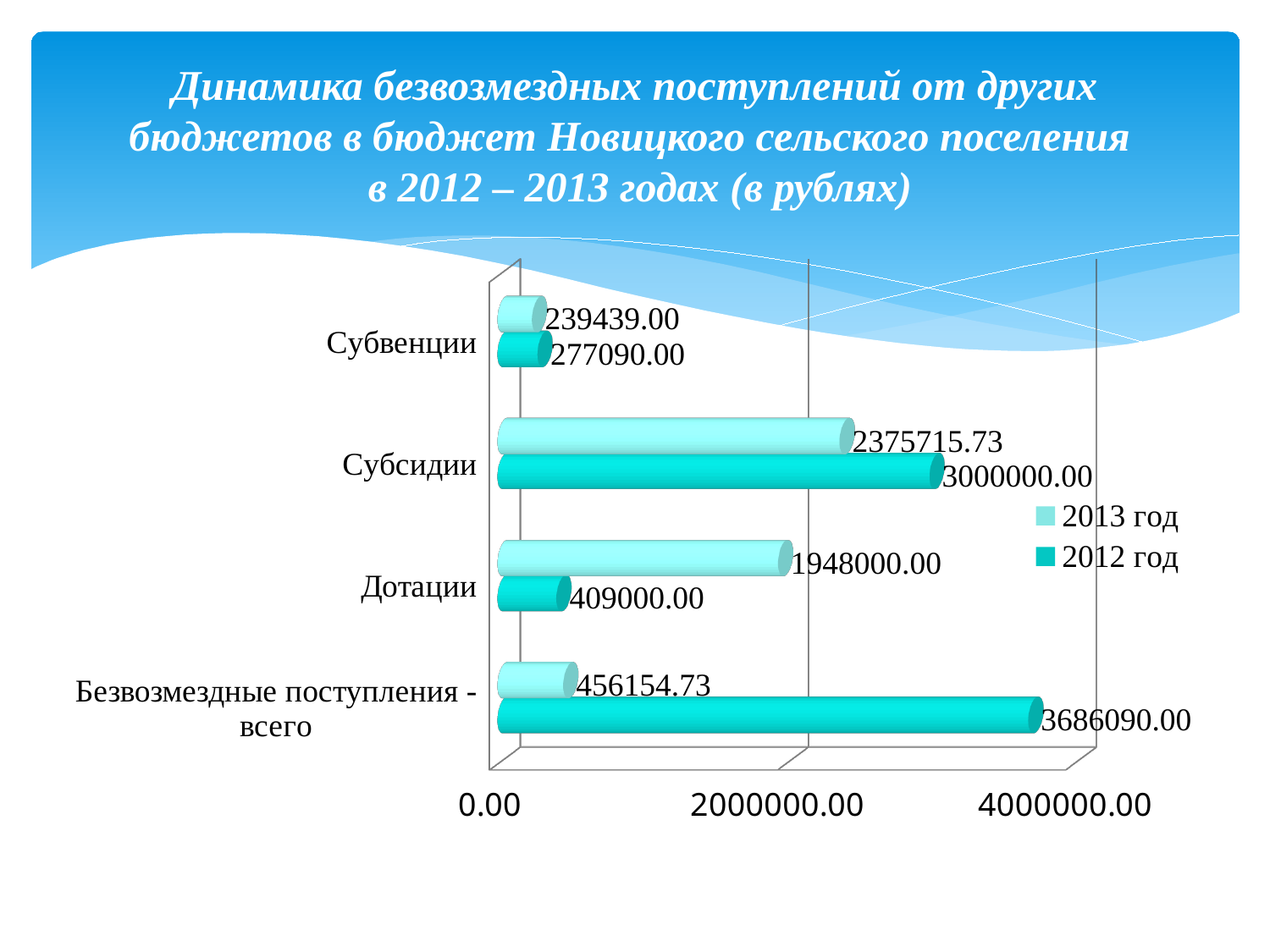
How many categories are shown on the chart? 4 How many series does the legend list? 2 What kind of chart is shown on the slide? Bar chart What is the difference between the 2012 год and 2013 год values for Субсидии? 624284.27 What is the difference between the 2012 год and 2013 год values for Дотации? 1539000.00 Which is larger for Дотации: the 2012 год value or the 2013 год value? 2013 год Which category has the highest value in the 2012 год series? Безвозмездные поступления - всего What is the value for Субсидии in the 2012 год series? 3000000.00 What is the value for Дотации in the 2013 год series? 1948000.00 What is the value for Субвенции in the 2013 год series? 239439.00 What is the value for Безвозмездные поступления - всего in the 2012 год series? 3686090.00 Which category has the lowest value in the 2013 год series? Субвенции